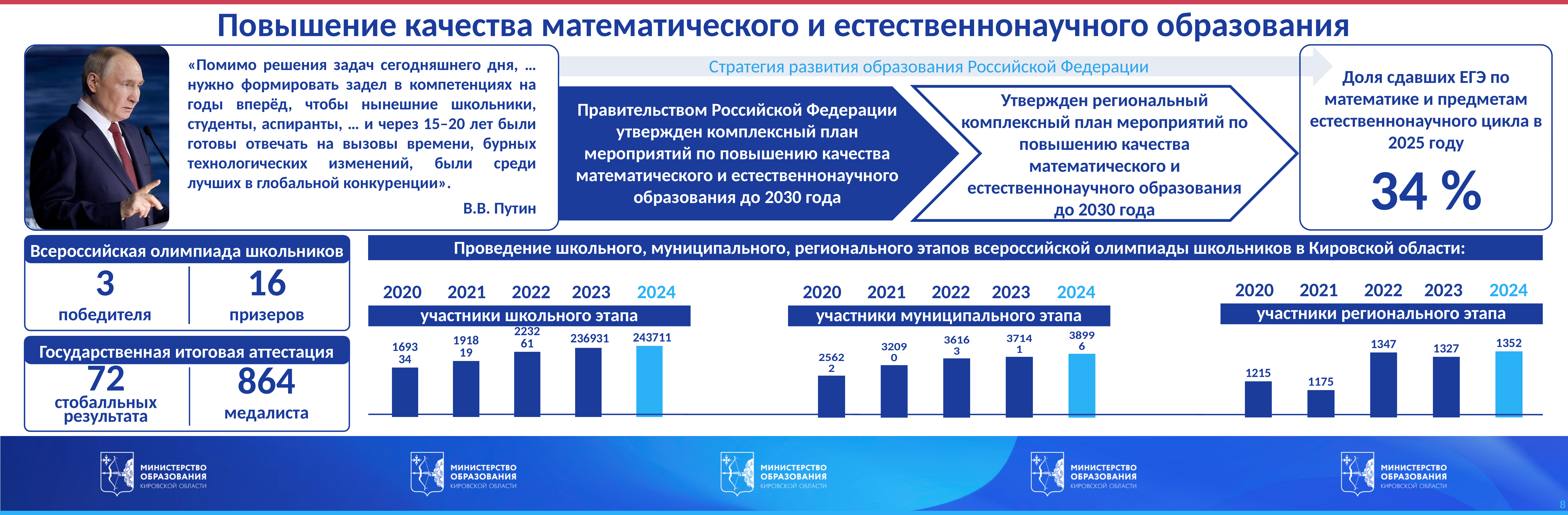
In the chart 'участники школьного этапа', do the values rise or fall from 2020 to 2024? rise In the chart 'участники регионального этапа', which is larger, the value for 2020 or for 2021? 2020 What kind of chart is 'участники регионального этапа'? bar chart How many years are shown in the chart 'участники школьного этапа'? 5 In the chart 'участники регионального этапа', what is the difference between the values for 2022 and 2021? 172 In the chart 'участники школьного этапа', what is the difference between the values for 2024 and 2023? 6780 In the chart 'участники регионального этапа', what is the value for 2024? 1352 In the chart 'участники регионального этапа', what is the difference between the values for 2024 and 2023? 25 In the chart 'участники школьного этапа', what is the value for 2023? 236931 In the chart 'участники регионального этапа', which year has the lowest value? 2021 In the chart 'участники муниципального этапа', which year has the highest value? 2024 In the chart 'участники муниципального этапа', what is the value for 2024? 38996